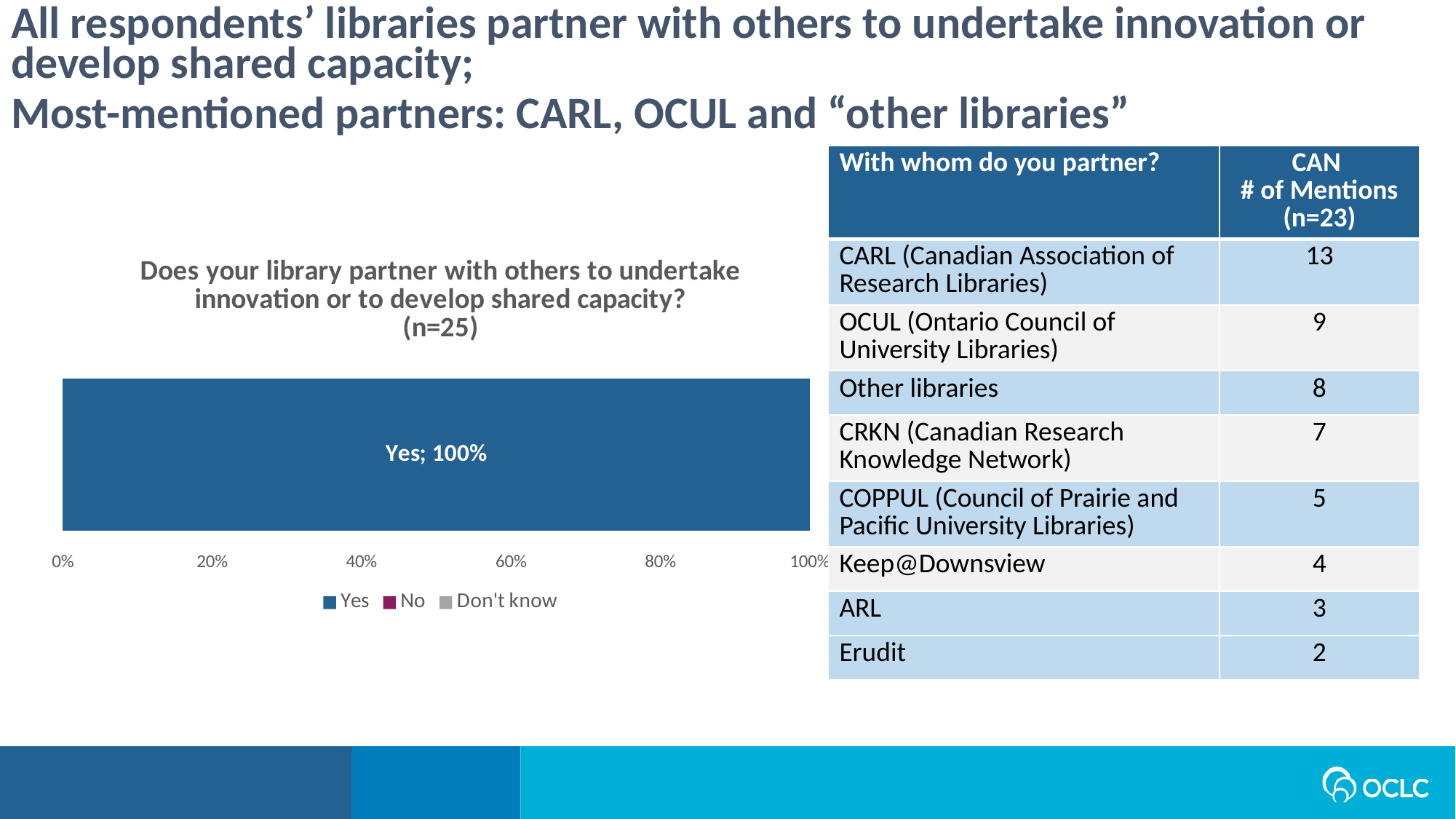
What is the sample size (n) stated in the chart title? n=25 How many series does the chart's legend list? 3 What is the highest value shown on the chart's x axis? 100% What are the three entries in the chart's legend? Yes, No, Don't know Is the value for Yes greater or less than 80%? greater How many bars are plotted in the chart? 1 What is the value shown for Yes in the bar chart? 100% What kind of chart is shown on the slide? bar chart